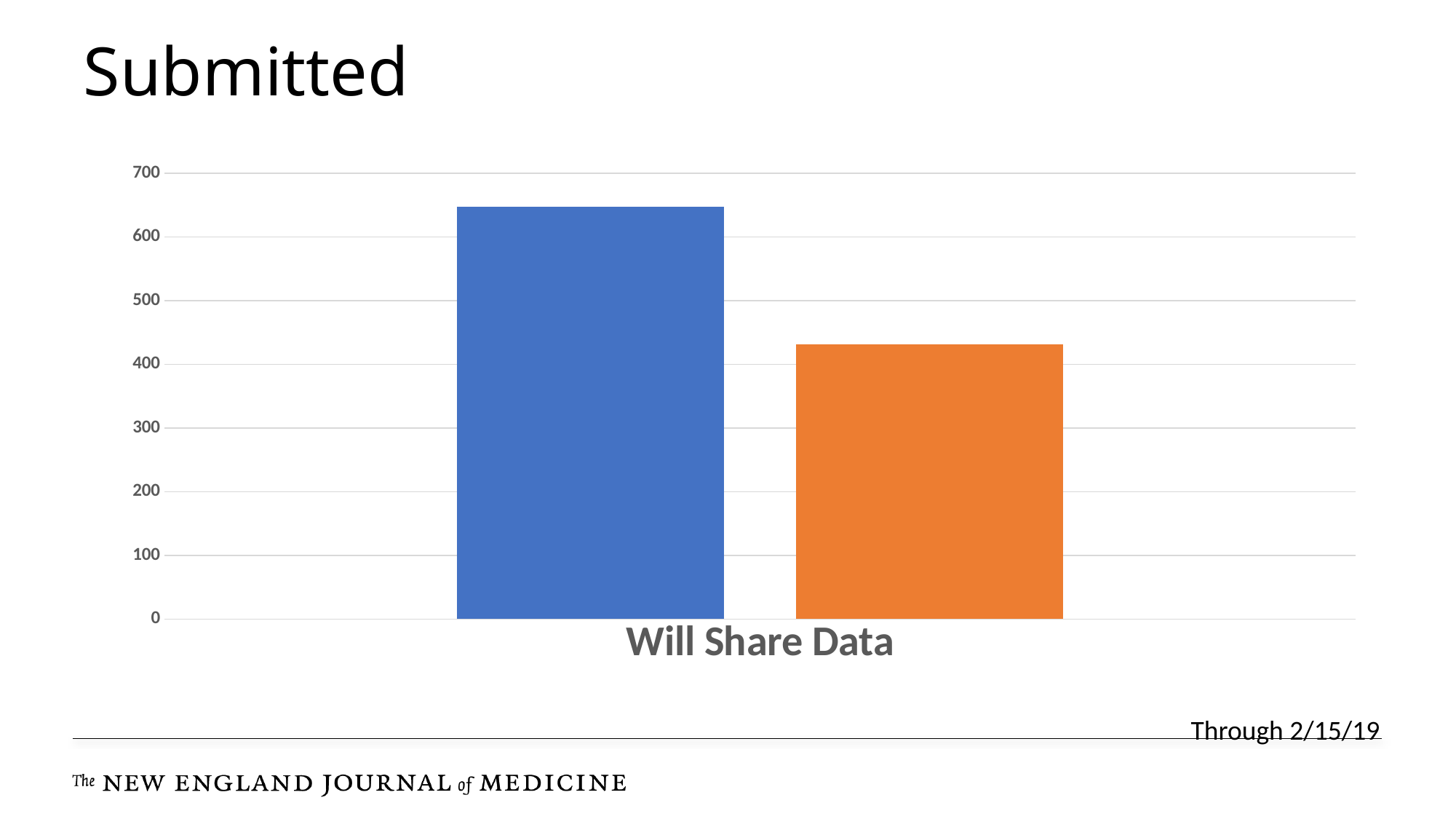
What kind of chart is shown on the slide? bar chart What is the title of the chart on the slide? Submitted Is the value of the orange bar greater or less than 400? greater Which bar has the lowest value in the chart? the orange bar Is the value of the blue bar greater or less than 600? greater Is the value of the blue bar greater or less than 700? less What is the highest value shown on the y axis of the chart? 700 How many bars are plotted in the chart? 2 Which bar is taller, the blue bar or the orange bar? the blue bar What is the category label shown on the x axis of the chart? Will Share Data